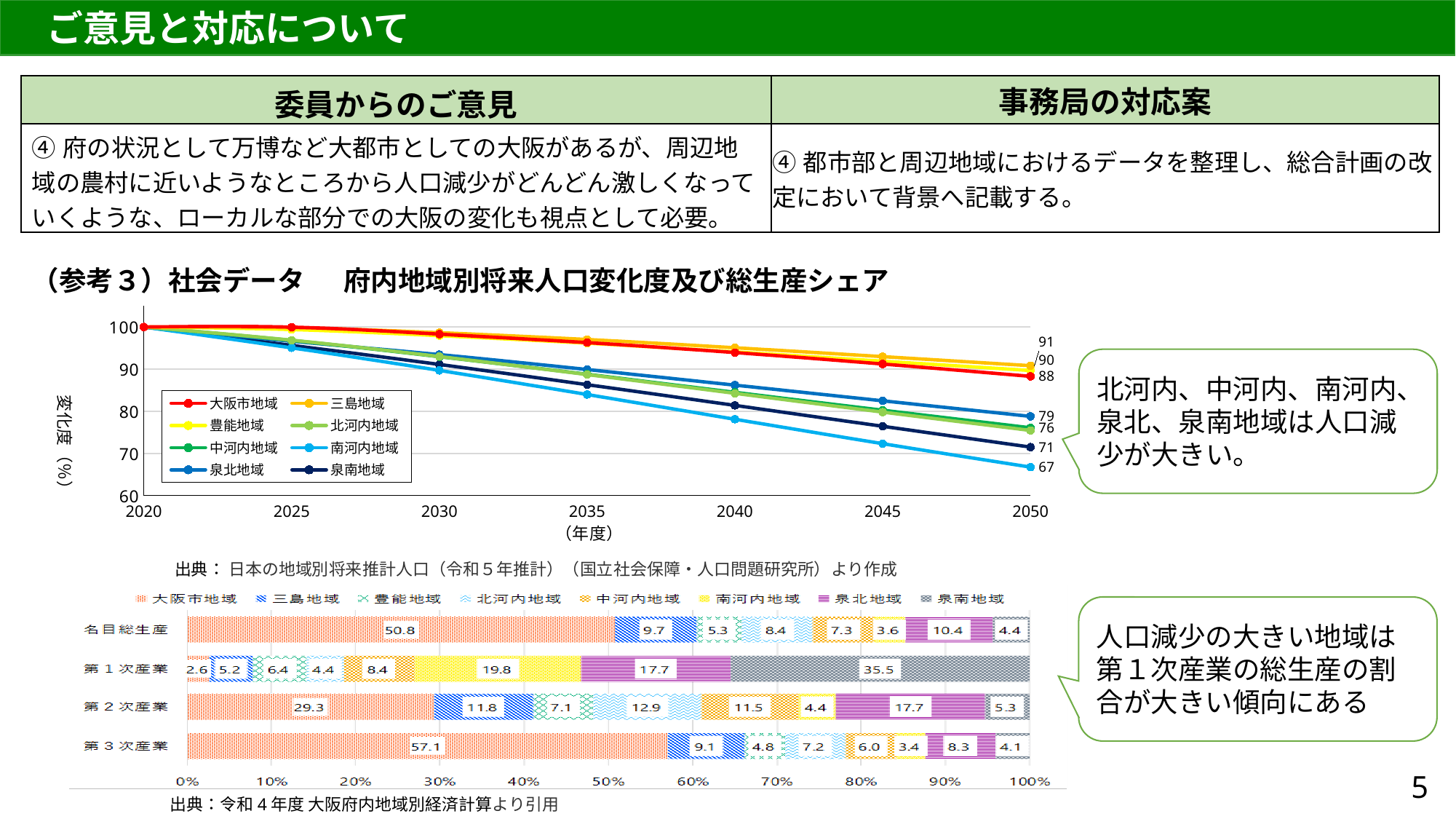
In the line chart (府内地域別将来人口変化度), which region has the lowest value in 2050? 南河内地域 In the line chart (府内地域別将来人口変化度), is the value for 南河内地域 in 2045 greater or less than 80? less What kind of chart is the lower chart (総生産シェア)? stacked bar chart In the line chart (府内地域別将来人口変化度), is the value for 大阪市地域 in 2040 greater or less than 90? greater In the line chart (府内地域別将来人口変化度), what is the value for 南河内地域 in 2050? 67 In the lower stacked bar chart (総生産シェア), which has the larger share of 第２次産業, 大阪市地域 or 泉北地域? 大阪市地域 In the line chart (府内地域別将来人口変化度), how many year points are plotted on the x axis? 7 In the line chart (府内地域別将来人口変化度), do the values rise or fall from 2020 to 2050? fall In the lower stacked bar chart (総生産シェア), what is the difference between the shares of 大阪市地域 and 三島地域 in 第３次産業? 48.0 In the lower stacked bar chart (総生産シェア), what is the share of 大阪市地域 in 名目総生産? 50.8 In the line chart (府内地域別将来人口変化度), how many series does the legend list? 8 In the lower stacked bar chart (総生産シェア), which region has the largest share of 第１次産業? 泉南地域